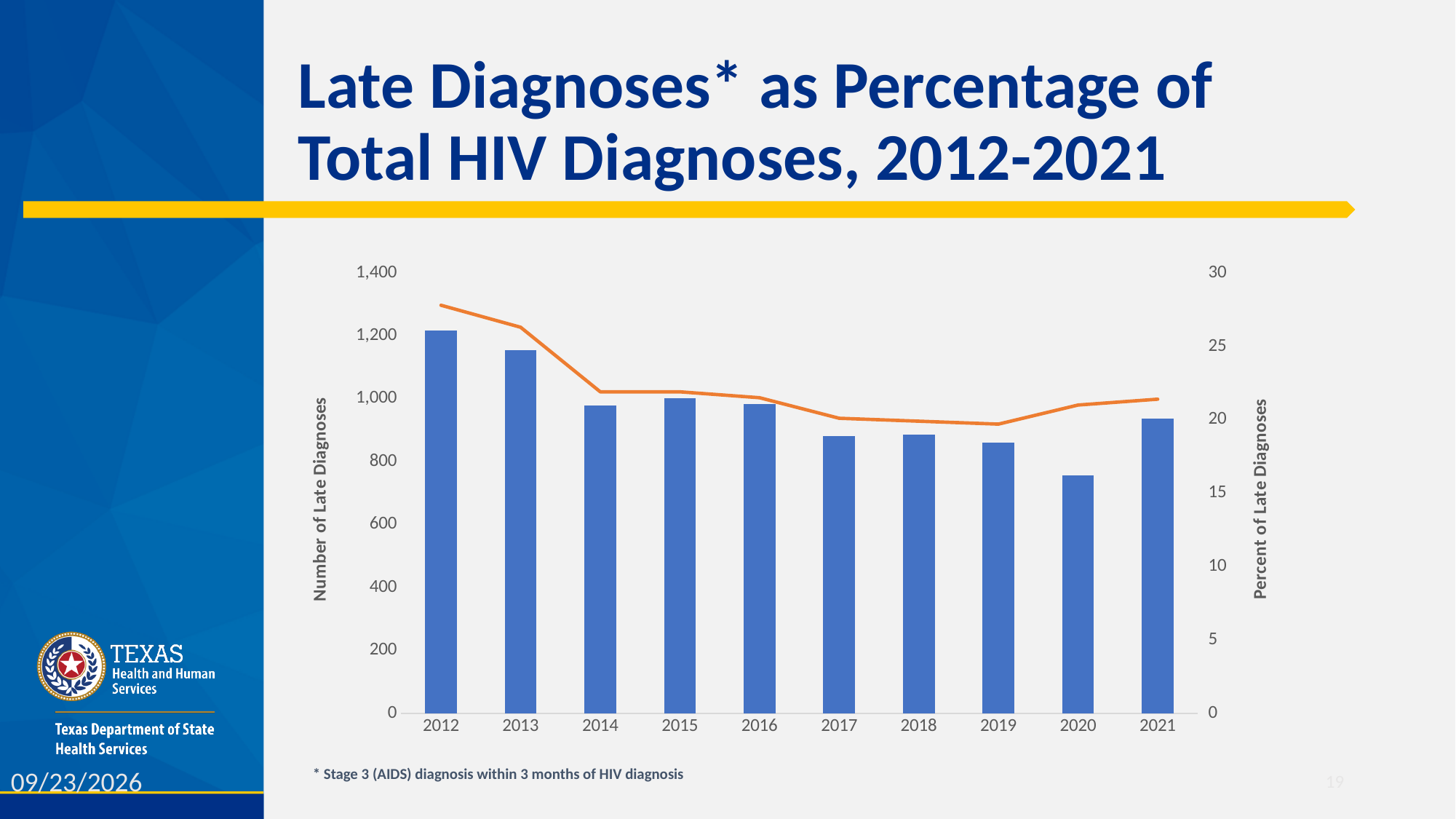
Is the percent of late diagnoses for 2012 greater or less than 25? greater How many years are shown on the x axis of the chart? 10 Which year has the larger number of late diagnoses, 2012 or 2013? 2012 What is the title of the right-hand vertical axis? Percent of Late Diagnoses Which year has the tallest bar for number of late diagnoses? 2012 Is the number of late diagnoses for 2021 greater or less than 1,000? less What kind of chart is shown on the slide? A bar chart with a line overlay Is the number of late diagnoses for 2013 greater or less than 1,000? greater Which year has the shortest bar for number of late diagnoses? 2020 In which year is the percent of late diagnoses line at its highest? 2012 Which year has the larger number of late diagnoses, 2020 or 2021? 2021